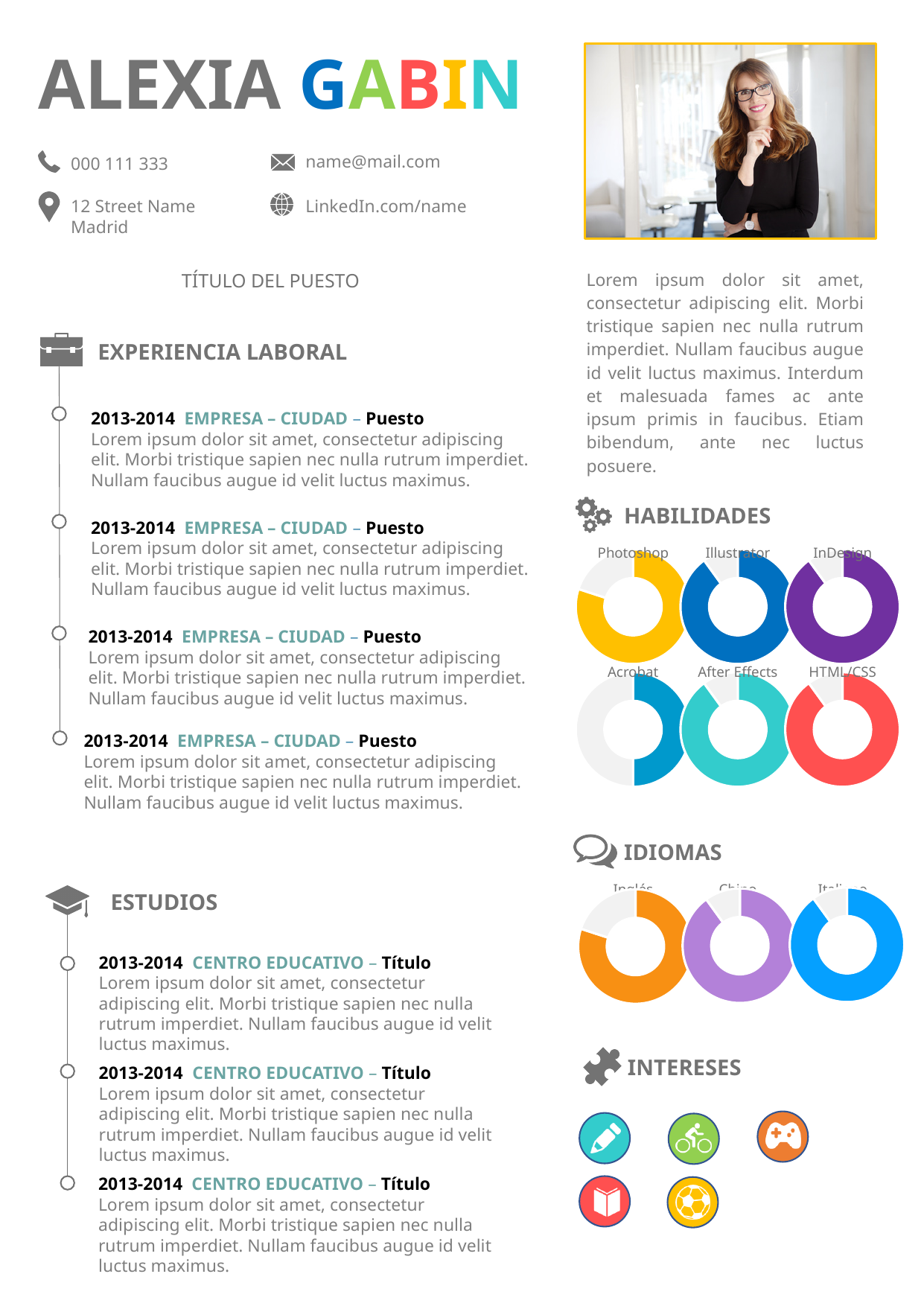
What kind of chart is used for each language in the IDIOMAS section? Donut chart How many skill donut charts are shown in the HABILIDADES section? 6 In the HABILIDADES section, which donut is more filled, Photoshop or Acrobat? Photoshop How many language donut charts are shown in the IDIOMAS section? 3 In the HABILIDADES section, which donut is more filled, Acrobat or HTML/CSS? HTML/CSS In the HABILIDADES section, which donut is more filled, Acrobat or Illustrator? Illustrator What colour is the HTML/CSS donut chart in the HABILIDADES section? Red In the HABILIDADES section, which skill has the lowest filled share of its donut? Acrobat What kind of chart is used to show each skill in the HABILIDADES section? Donut chart What colour is the Photoshop donut chart in the HABILIDADES section? Yellow